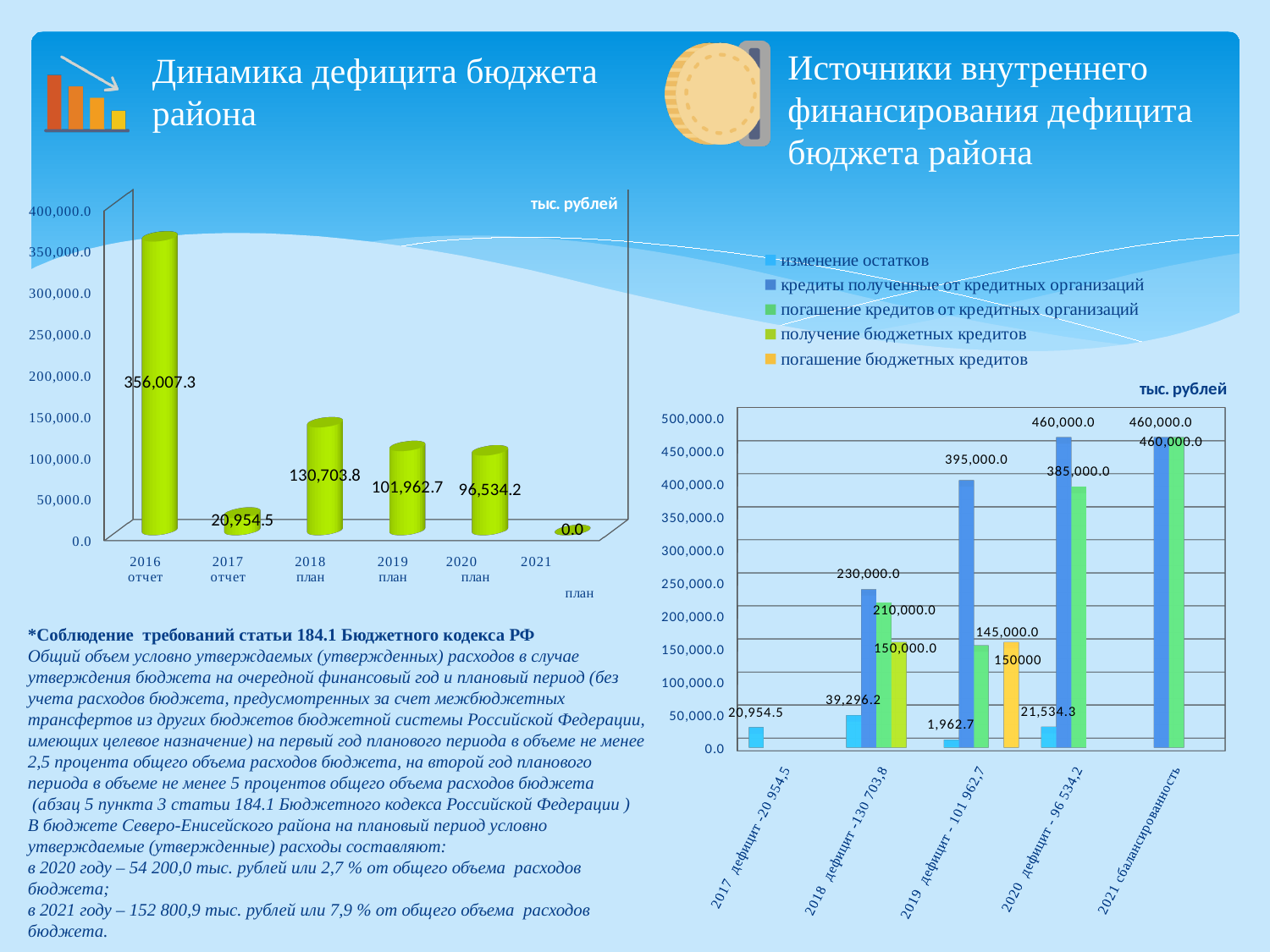
In the chart 'Динамика дефицита бюджета района', what is the value for 2019 план? 101,962.7 In the chart 'Динамика дефицита бюджета района', how many years are shown on the x axis? 6 In the chart 'Динамика дефицита бюджета района', which year has the highest value? 2016 отчет In the chart 'Источники внутреннего финансирования дефицита бюджета района', which is larger for 2020: 'кредиты полученные от кредитных организаций' or 'погашение кредитов от кредитных организаций'? кредиты полученные от кредитных организаций In the chart 'Источники внутреннего финансирования дефицита бюджета района', what is the value of 'изменение остатков' for 2018? 39,296.2 In the chart 'Источники внутреннего финансирования дефицита бюджета района', what is the difference between 'кредиты полученные от кредитных организаций' and 'погашение кредитов от кредитных организаций' for 2018? 20,000.0 In the chart 'Динамика дефицита бюджета района', what is the value for 2016 отчет? 356,007.3 In the chart 'Динамика дефицита бюджета района', what is the difference between the values for 2018 план and 2020 план? 34,169.6 In the chart 'Источники внутреннего финансирования дефицита бюджета района', what is the value of 'кредиты полученные от кредитных организаций' for 2019? 395,000.0 In the chart 'Динамика дефицита бюджета района', which year has the lowest value? 2021 план In the chart 'Источники внутреннего финансирования дефицита бюджета района', how many series does the legend list? 5 In the chart 'Динамика дефицита бюджета района', what kind of chart is used? Bar chart